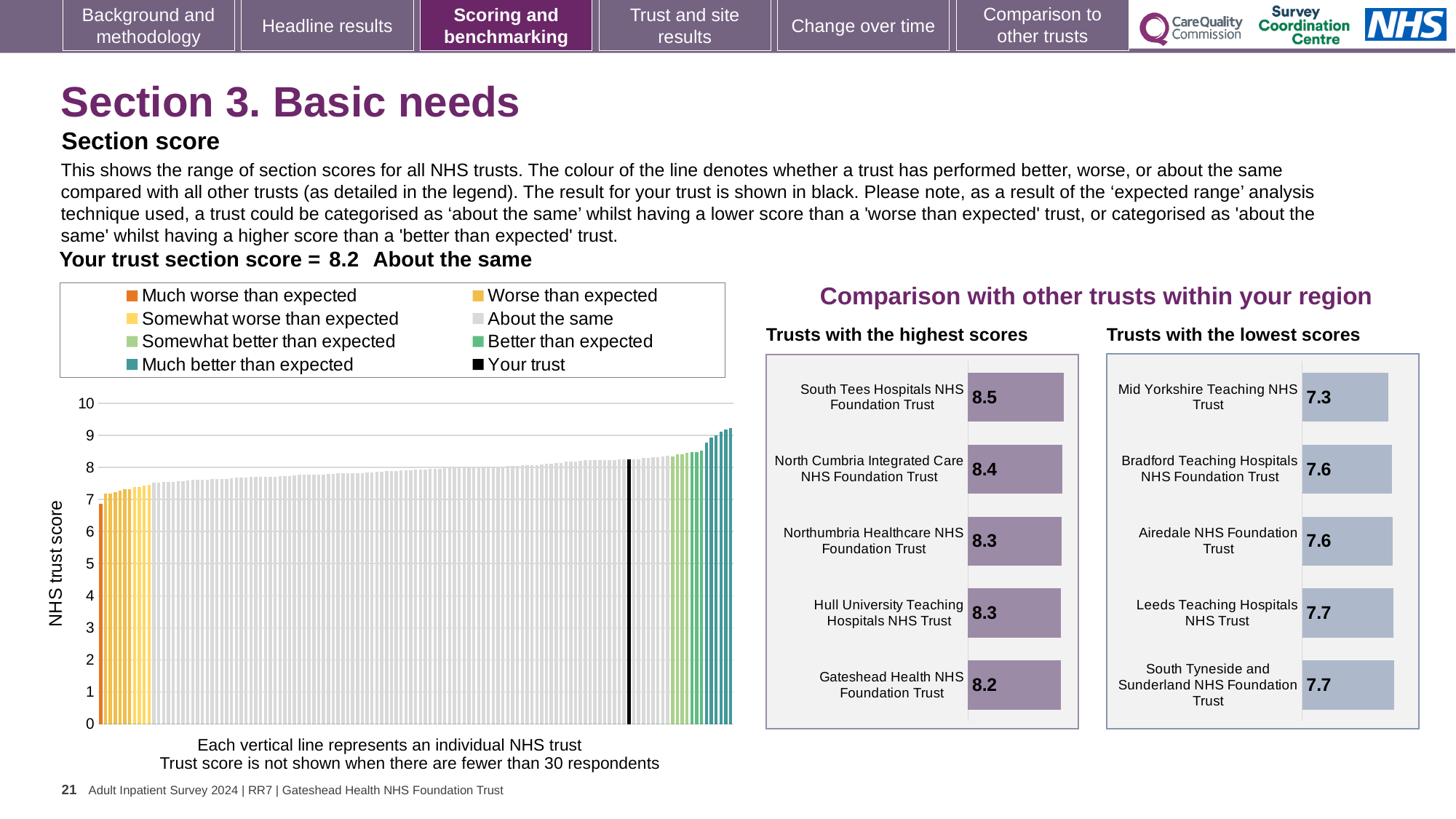
In the 'Trusts with the highest scores' chart, how many trusts are listed? 5 In the large 'NHS trust score' chart on the left, do the bar values rise or fall from left to right? Rise How many entries does the legend of the large 'NHS trust score' chart on the left list? 8 What kind of chart is the large 'NHS trust score' chart on the left of the slide? Bar chart In the 'Trusts with the lowest scores' chart, which trust has the lowest score? Mid Yorkshire Teaching NHS Trust In the 'Trusts with the highest scores' chart, what is the score for Gateshead Health NHS Foundation Trust? 8.2 In the 'Trusts with the highest scores' chart, which trust has the highest score? South Tees Hospitals NHS Foundation Trust In the 'Trusts with the lowest scores' chart, what is the difference between the scores of South Tyneside and Sunderland NHS Foundation Trust and Mid Yorkshire Teaching NHS Trust? 0.4 In the 'Trusts with the highest scores' chart, what is the difference between the scores of South Tees Hospitals NHS Foundation Trust and Gateshead Health NHS Foundation Trust? 0.3 In the 'Trusts with the lowest scores' chart, which has the larger score: Bradford Teaching Hospitals NHS Foundation Trust or Leeds Teaching Hospitals NHS Trust? Leeds Teaching Hospitals NHS Trust In the 'Trusts with the lowest scores' chart, what is the score for Mid Yorkshire Teaching NHS Trust? 7.3 In the 'Trusts with the highest scores' chart, what is the score for South Tees Hospitals NHS Foundation Trust? 8.5